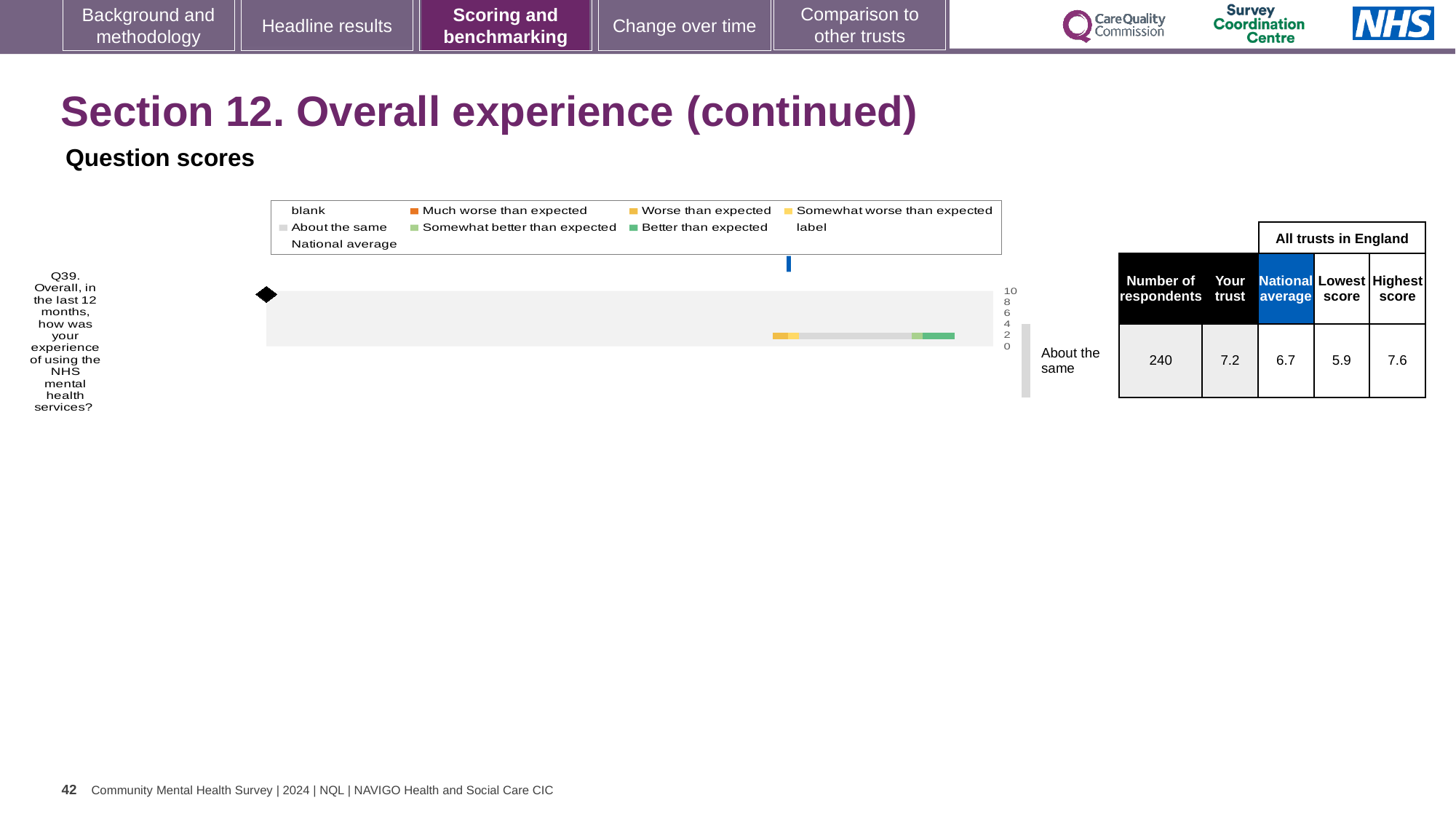
Which question number is plotted in the chart? Q39 What is the 'Your trust' score for Q39? 7.2 Which is higher for Q39: the 'Your trust' score or the national average? Your trust How many respondents answered Q39? 240 What benchmark category label is shown next to the bar for Q39? About the same By how much does the 'Your trust' score for Q39 exceed the national average? 0.5 What type of chart is shown on the slide? bar chart How many survey questions are plotted in the chart? 1 What is the difference between the highest and lowest scores for Q39 across all trusts in England? 1.7 What is the national average score for Q39? 6.7 What is the lowest score among all trusts in England for Q39? 5.9 What is the highest score among all trusts in England for Q39? 7.6